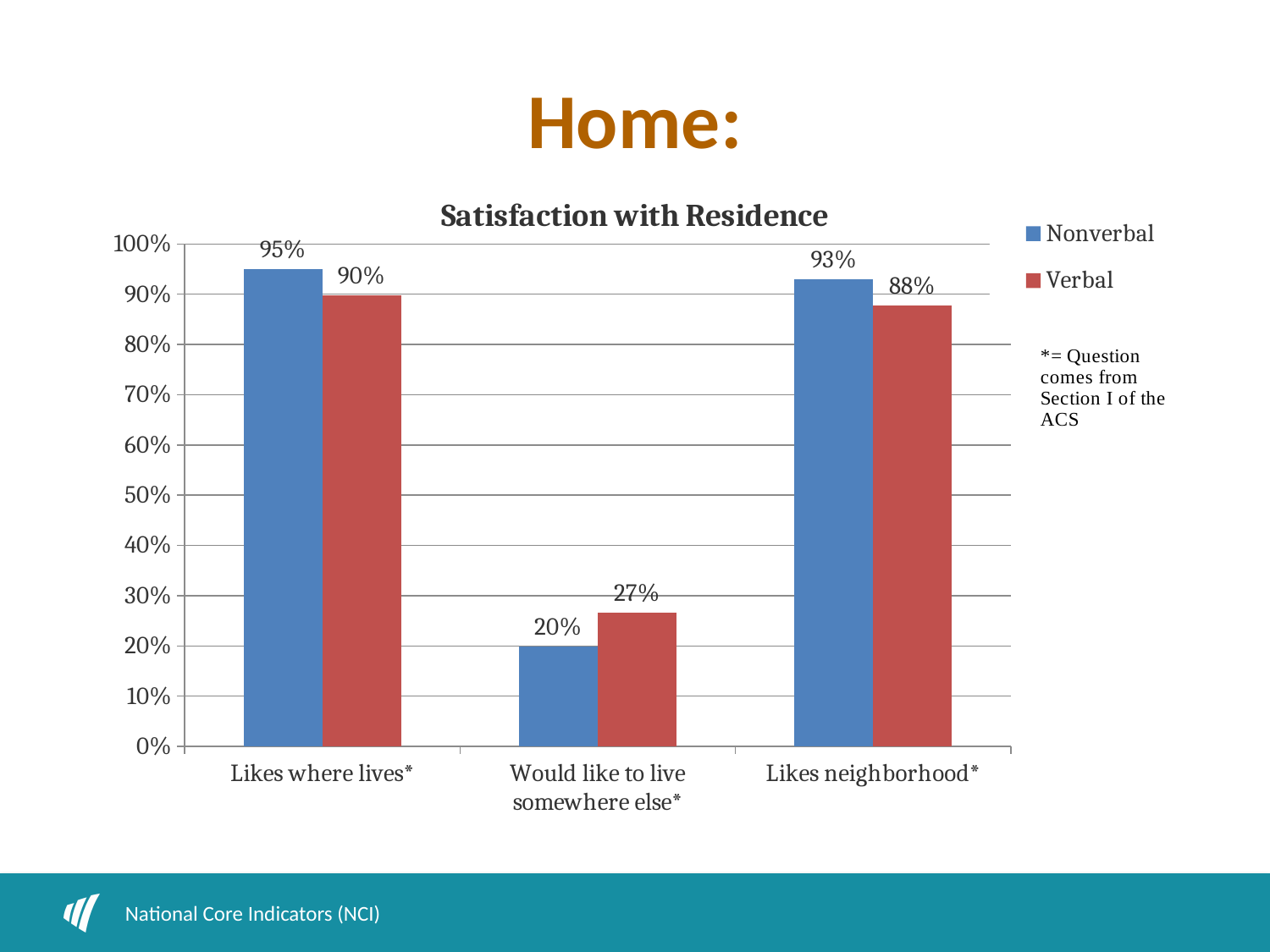
Which category has the lowest Verbal value? Would like to live somewhere else* What is the Verbal value for "Would like to live somewhere else*"? 27% For "Would like to live somewhere else*", which series has the larger value, Nonverbal or Verbal? Verbal How many series does the legend list? 2 What is the Nonverbal value for "Would like to live somewhere else*"? 20% What is the title of the chart? Satisfaction with Residence What is the difference between the Nonverbal and Verbal values for "Likes neighborhood*"? 5% What is the Nonverbal value for "Likes where lives*"? 95% What kind of chart is shown on the slide? Bar chart How many categories are shown on the x axis? 3 Which category has the highest Nonverbal value? Likes where lives* What is the Verbal value for "Likes neighborhood*"? 88%